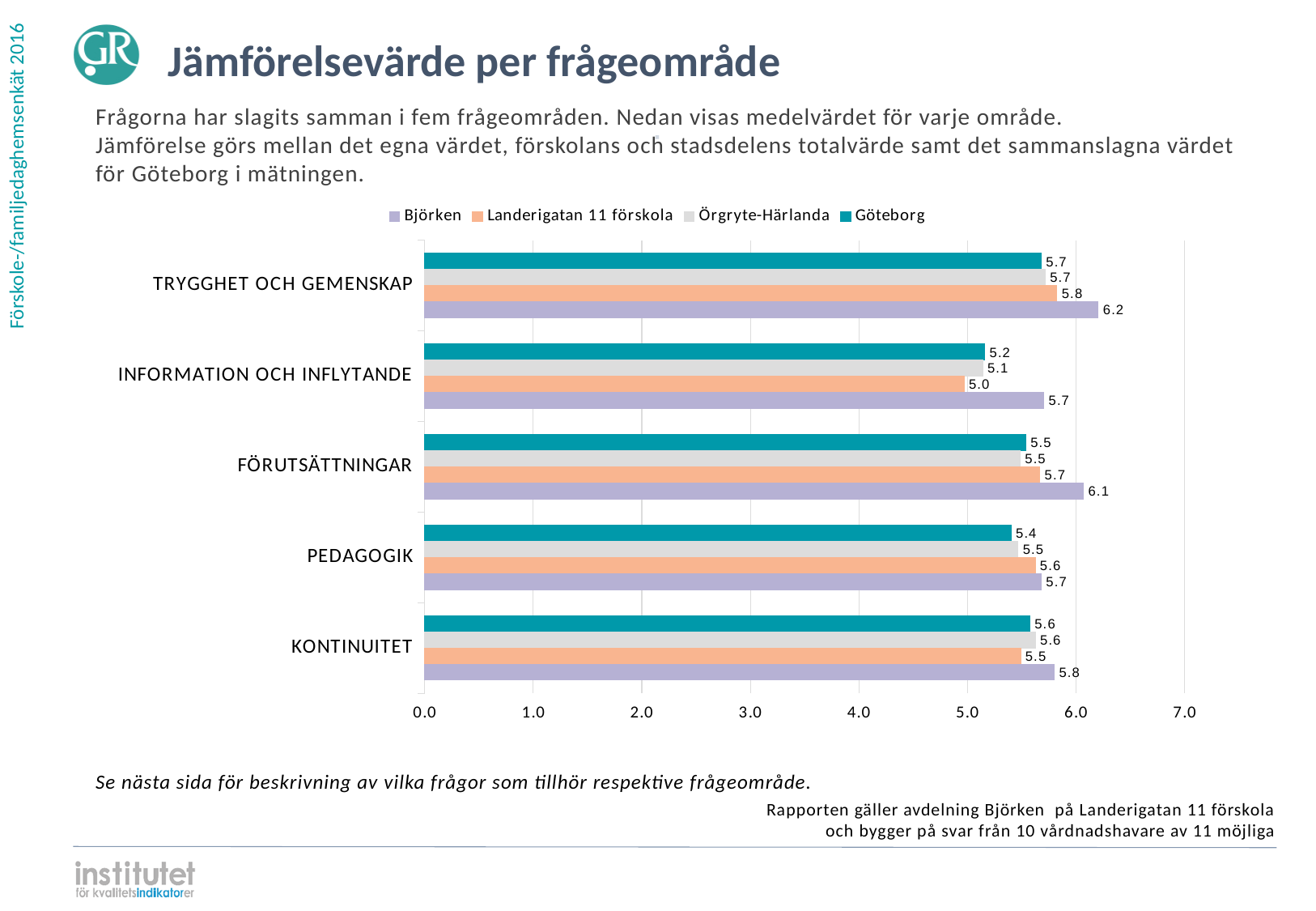
Which is larger in KONTINUITET: Björken or Landerigatan 11 förskola? Björken In which question area does Landerigatan 11 förskola have its lowest value? INFORMATION OCH INFLYTANDE What is the value for Björken in TRYGGHET OCH GEMENSKAP? 6.2 Which series is shown in teal on the chart? Göteborg How many question areas (categories) are shown on the chart? 5 What is the difference between Björken and Göteborg in FÖRUTSÄTTNINGAR? 0.6 In which question area does Björken have its highest value? TRYGGHET OCH GEMENSKAP What is the value for Göteborg in PEDAGOGIK? 5.4 What is the value for Örgryte-Härlanda in KONTINUITET? 5.6 How many series does the legend list? 4 What kind of chart is shown on the slide? Bar chart What is the value for Landerigatan 11 förskola in INFORMATION OCH INFLYTANDE? 5.0